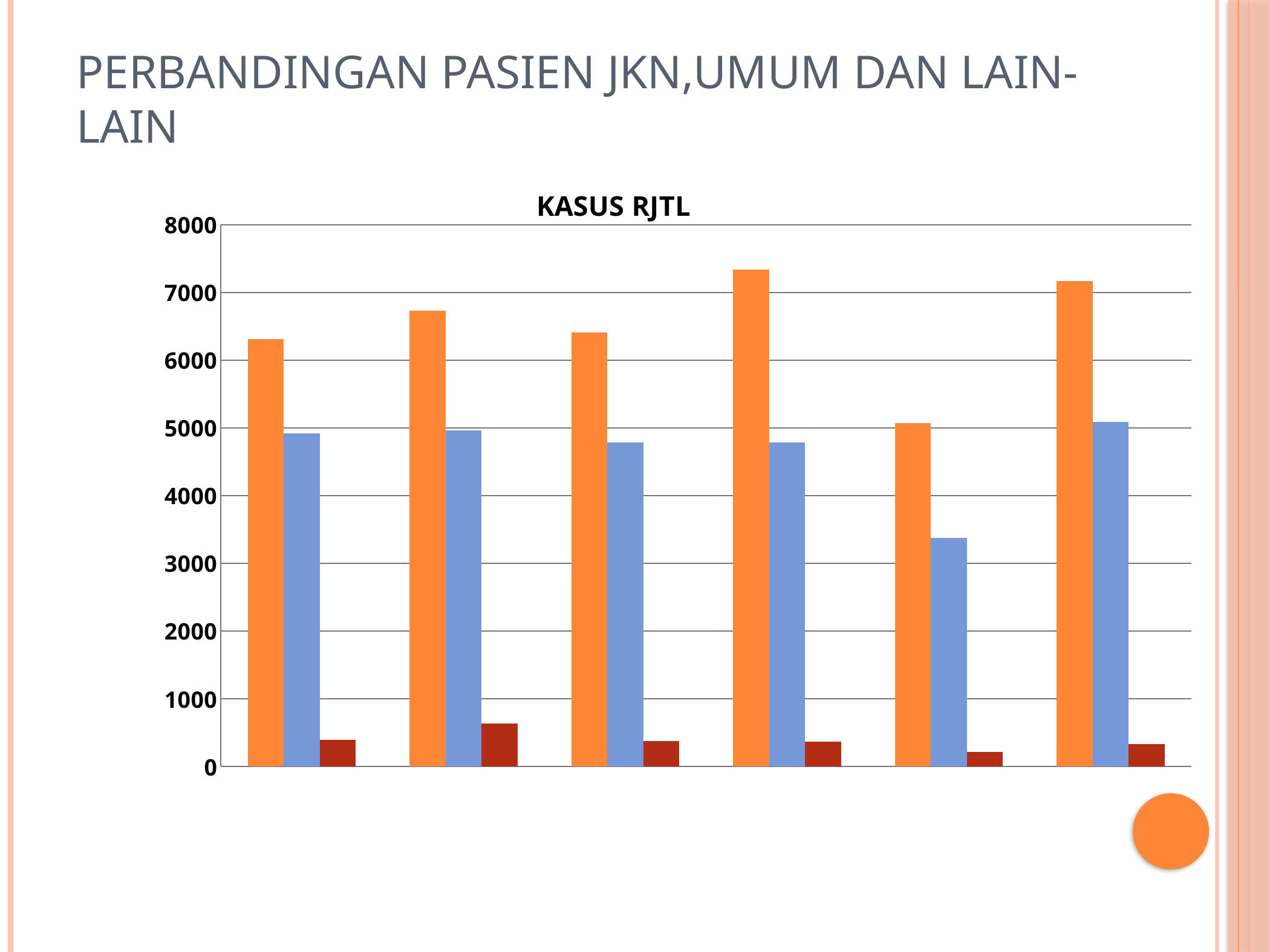
Is the orange bar in the sixth group greater or less than 7000? greater What kind of chart is shown on the slide? bar chart How many groups of bars are plotted along the x axis? 6 In which group (by position from the left) is the blue bar the lowest? fifth In which group (by position from the left) is the orange bar the lowest? fifth Which colour of bar is the tallest in every group? orange Is the blue bar in the fifth group greater or less than 4000? less In which group (by position from the left) is the dark red bar the highest? second Is the orange bar in the first group greater or less than 6000? greater In which group (by position from the left) is the orange bar the highest? fourth What is the title of the chart? KASUS RJTL How many bars are there in each group? 3